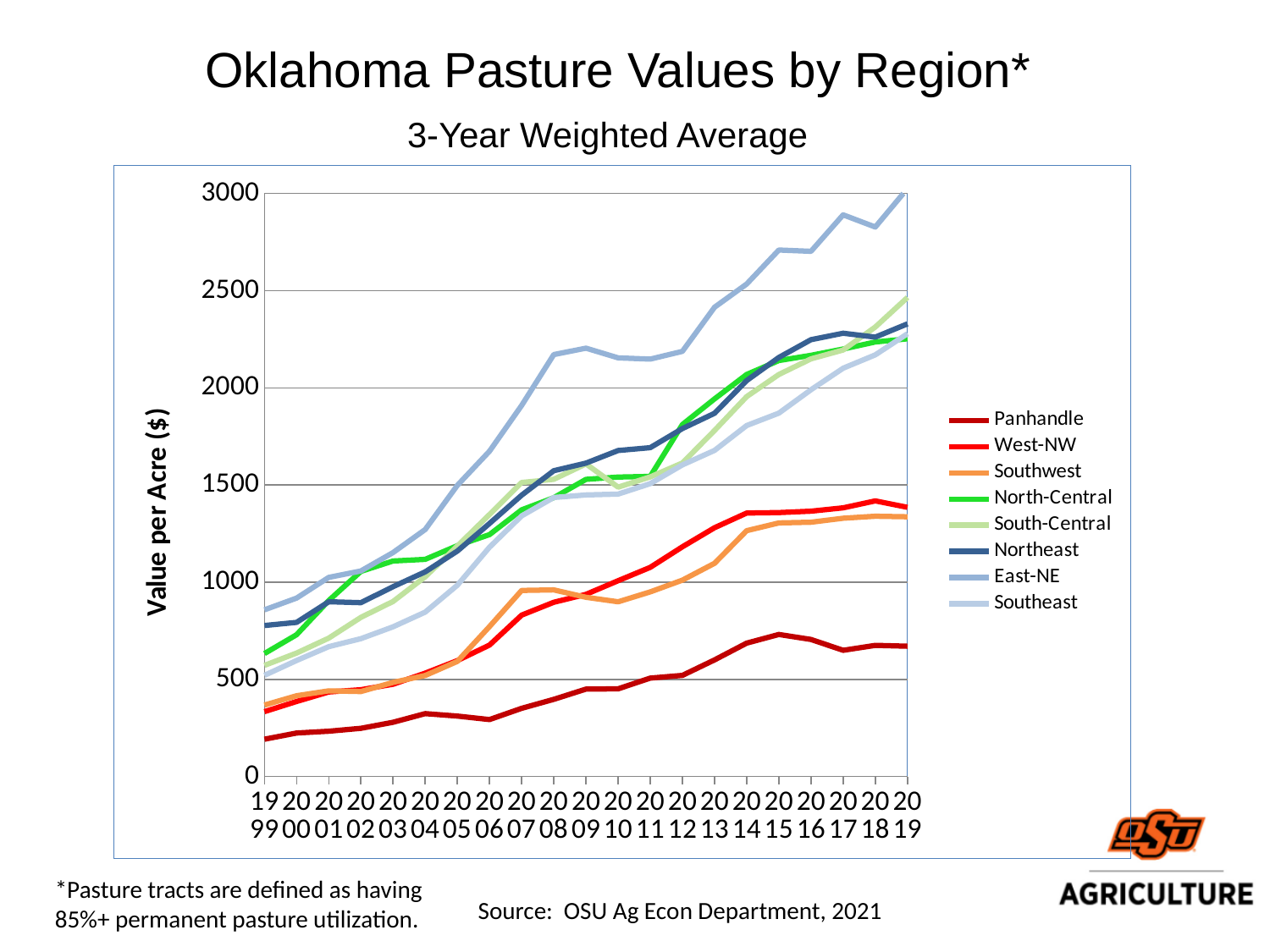
Is the value for East-NE in 2008 greater or less than 2000? greater Which region has the lowest pasture value in 2019? Panhandle Which region has the highest pasture value in 2019? East-NE Do the East-NE pasture values generally rise or fall from 1999 to 2019? rise Is the value for Panhandle in 1999 greater or less than 500? less What is the label on the y axis of the chart? Value per Acre ($) Is the value for Panhandle in 2019 greater or less than 1000? less How many years are plotted along the x axis? 21 Which is larger in 2010, the value for West-NW or the value for Panhandle? West-NW What kind of chart is shown on the slide? line chart How many series does the legend list? 8